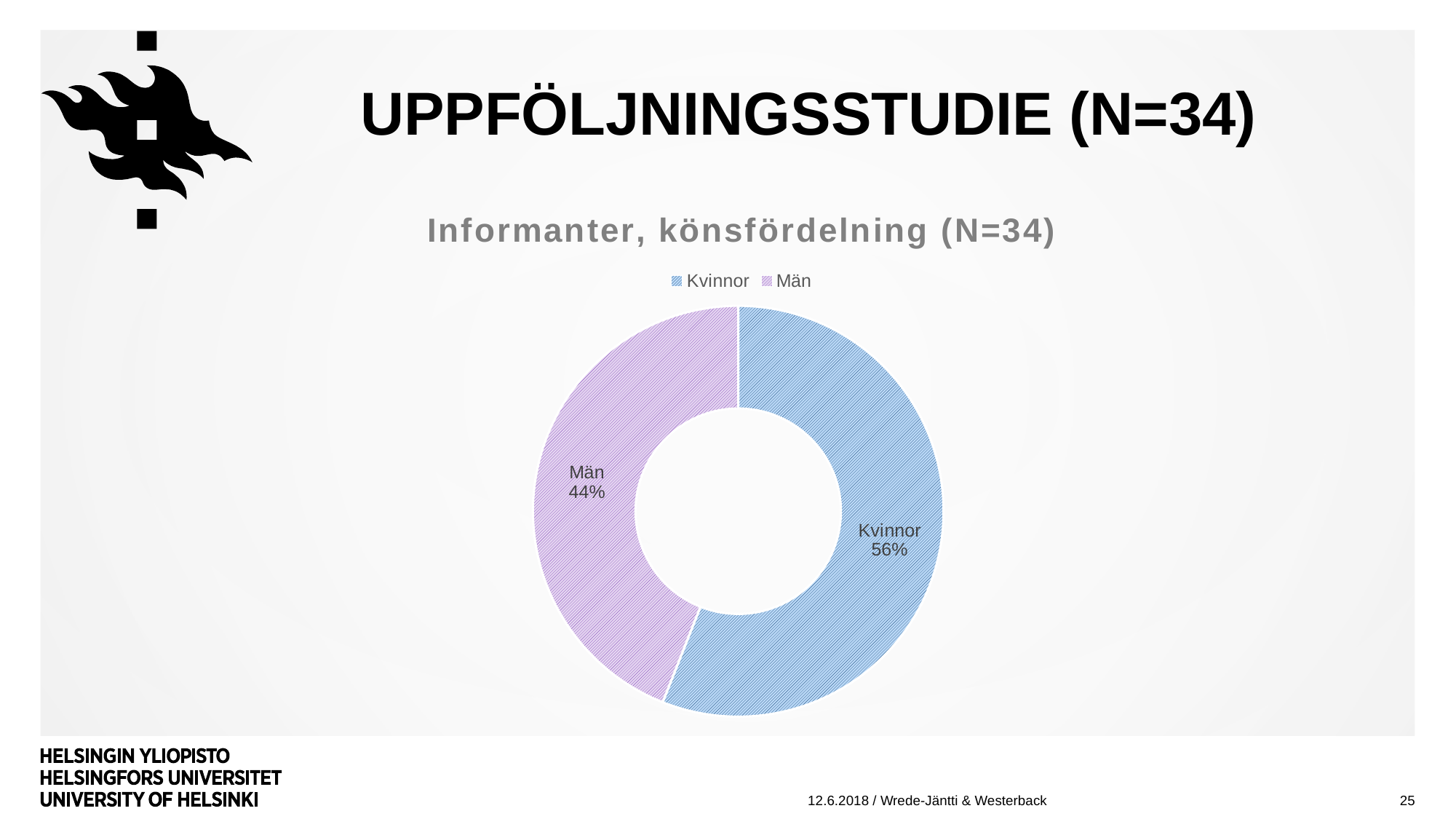
Which category has the largest share in the chart? Kvinnor What share of the pie does Kvinnor represent? 56% What kind of chart is shown on the slide? Pie chart (doughnut) What share of the pie does Män represent? 44% What is the difference in percentage points between the Kvinnor and Män shares? 12 Which colour represents Män in the chart? Purple What is the title of the chart? Informanter, könsfördelning (N=34) Which category has the smallest share in the chart? Män How many entries does the legend list? 2 Which is larger, the share for Kvinnor or the share for Män? Kvinnor How many categories are shown in the chart? 2